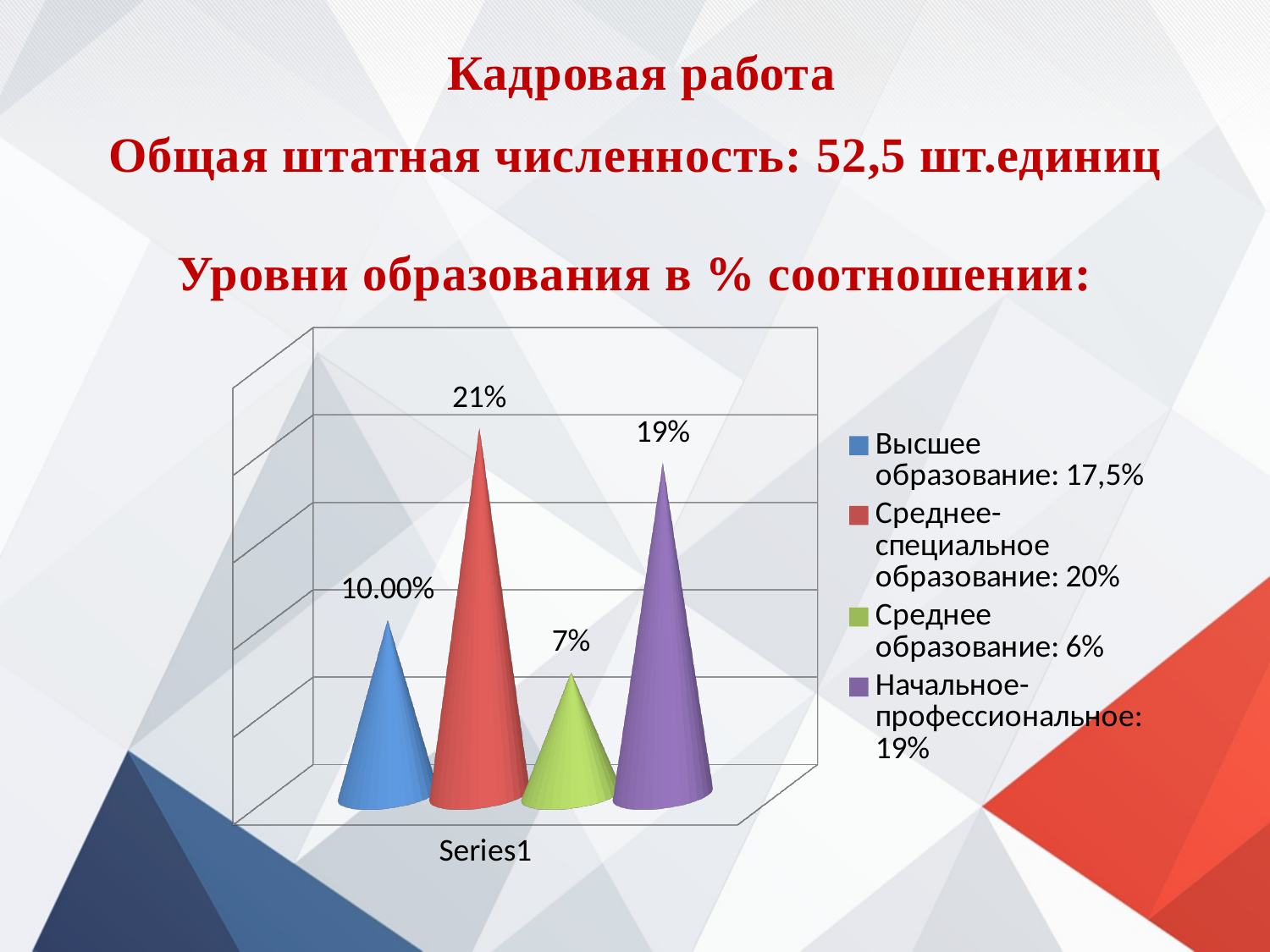
How many entries does the chart legend list? 4 Which series has the shortest cone in the chart? Среднее образование How many cones are plotted in the chart? 4 What type of chart is shown on the slide? Bar chart (3D cone bars) What label appears on the horizontal axis below the cones? Series1 What data label is shown above the green cone for Среднее образование? 7% What data label is shown above the purple cone for Начальное-профессиональное? 19% What is the difference between the data labels of the red cone (21%) and the green cone (7%)? 14% What data label is shown above the red cone for Среднее-специальное образование? 21% Which is larger according to the data labels: the blue cone or the purple cone? The purple cone (Начальное-профессиональное) What data label is shown above the blue cone for Высшее образование? 10.00% Which series has the tallest cone in the chart? Среднее-специальное образование